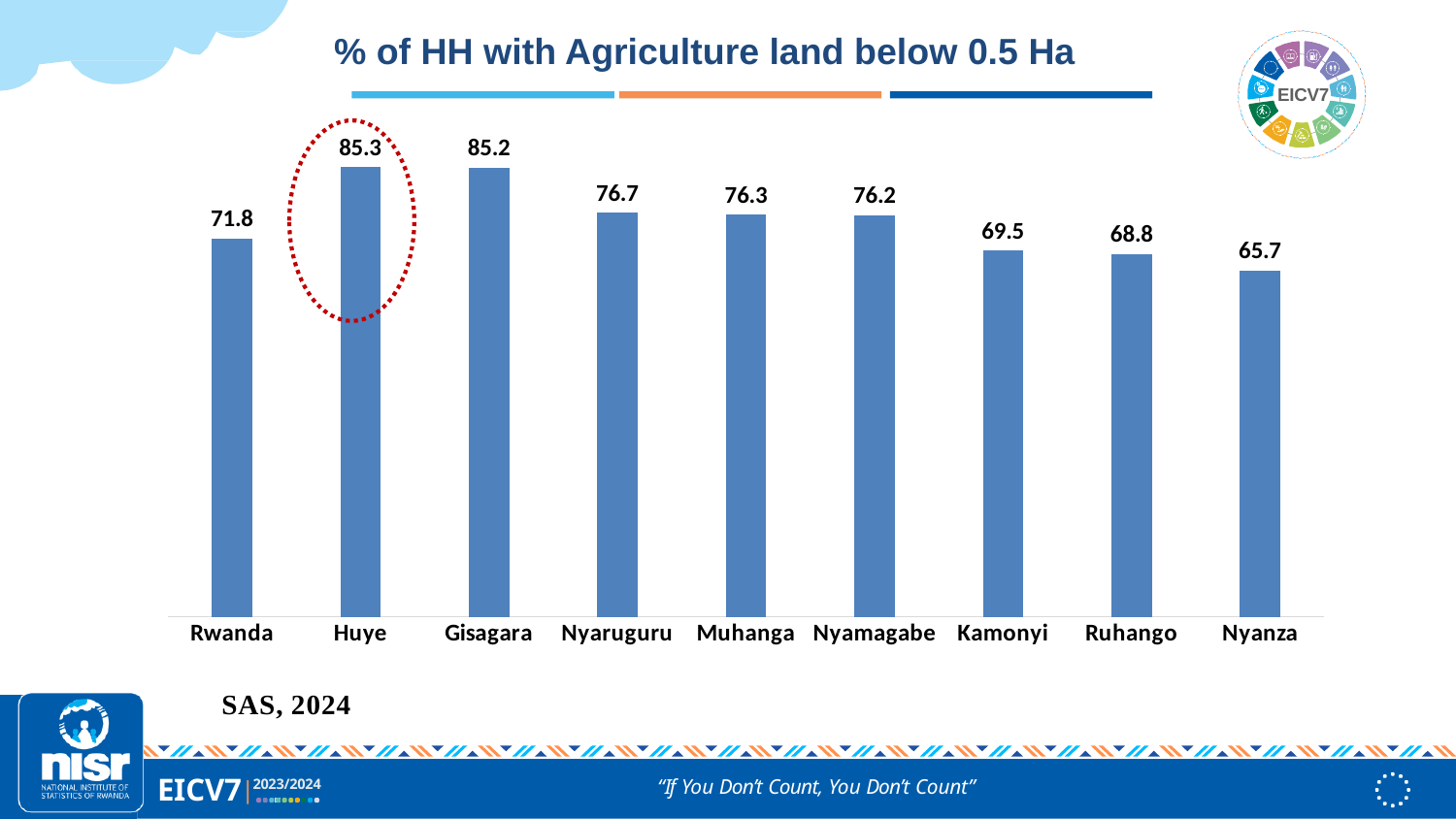
Which is larger, the value for Kamonyi or the value for Nyaruguru? Nyaruguru Which category has the highest value? Huye Which category has the lowest value? Nyanza What is the value for Huye? 85.3 Which bar is highlighted with a red dotted circle? Huye What kind of chart is shown on the slide? Bar chart What is the difference between the values for Gisagara and Nyanza? 29.5 What is the value for Nyamagabe? 76.2 What is the value for Ruhango? 68.8 What is the value for Rwanda? 71.8 How many categories are shown on the x axis? 9 What is the difference between the values for Huye and Rwanda? 13.5